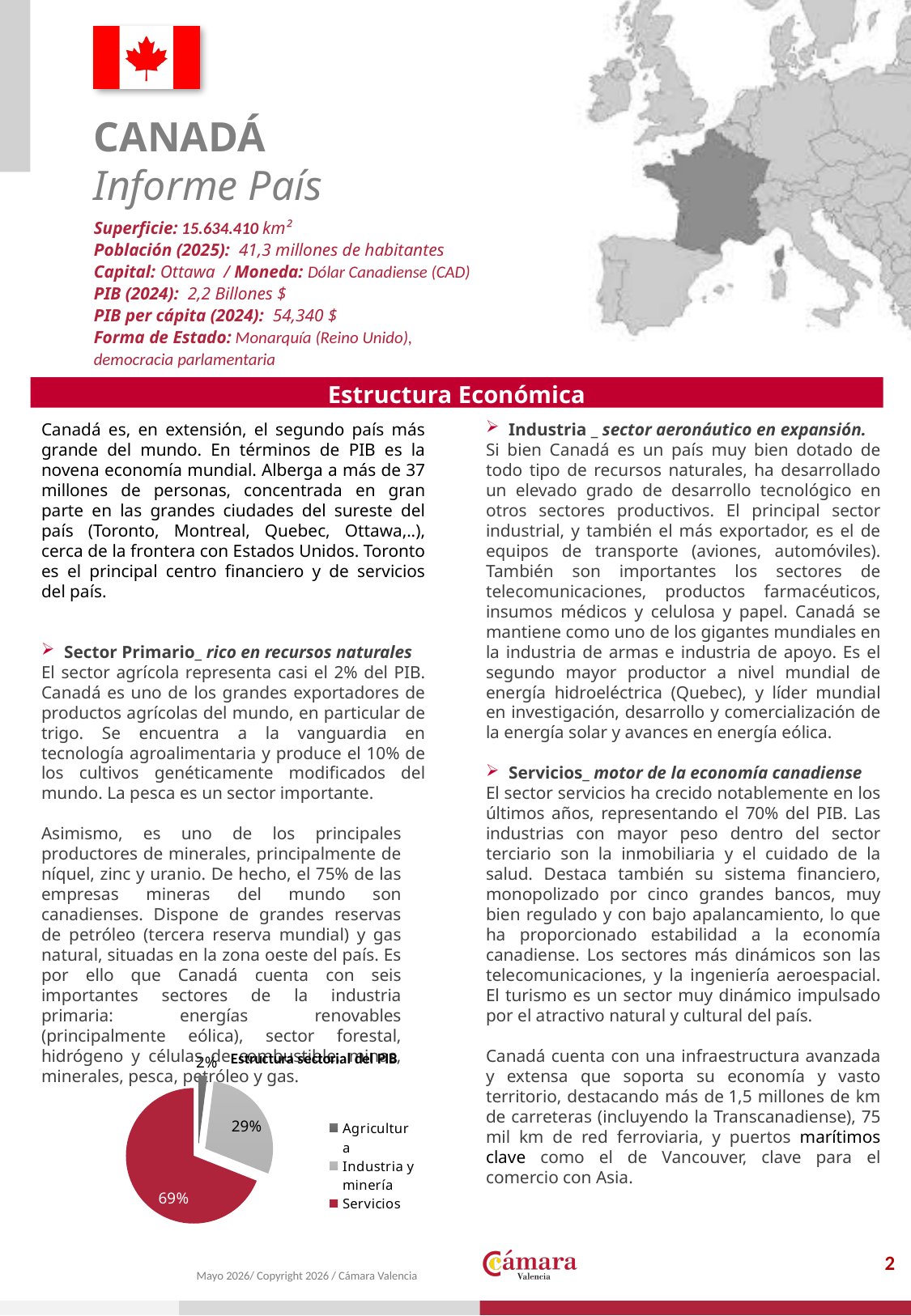
In the pie chart, which is larger: Industria y minería or Agricultura? Industria y minería In the pie chart, what share of GDP does Servicios represent? 69% How many entries does the legend of the pie chart list? 3 In the pie chart, what share of GDP does Agricultura represent? 2% How many slices does the pie chart have? 3 Which sector has the largest slice in the pie chart? Servicios In the pie chart, what share of GDP does Industria y minería represent? 29% In the pie chart, what is the combined share of Agricultura and Industria y minería? 31% Which sector has the smallest slice in the pie chart? Agricultura In the pie chart, what is the difference in percentage points between Servicios and Industria y minería? 40 What kind of chart is shown at the bottom left of the slide? Pie chart What colour is the Servicios slice in the pie chart? Red